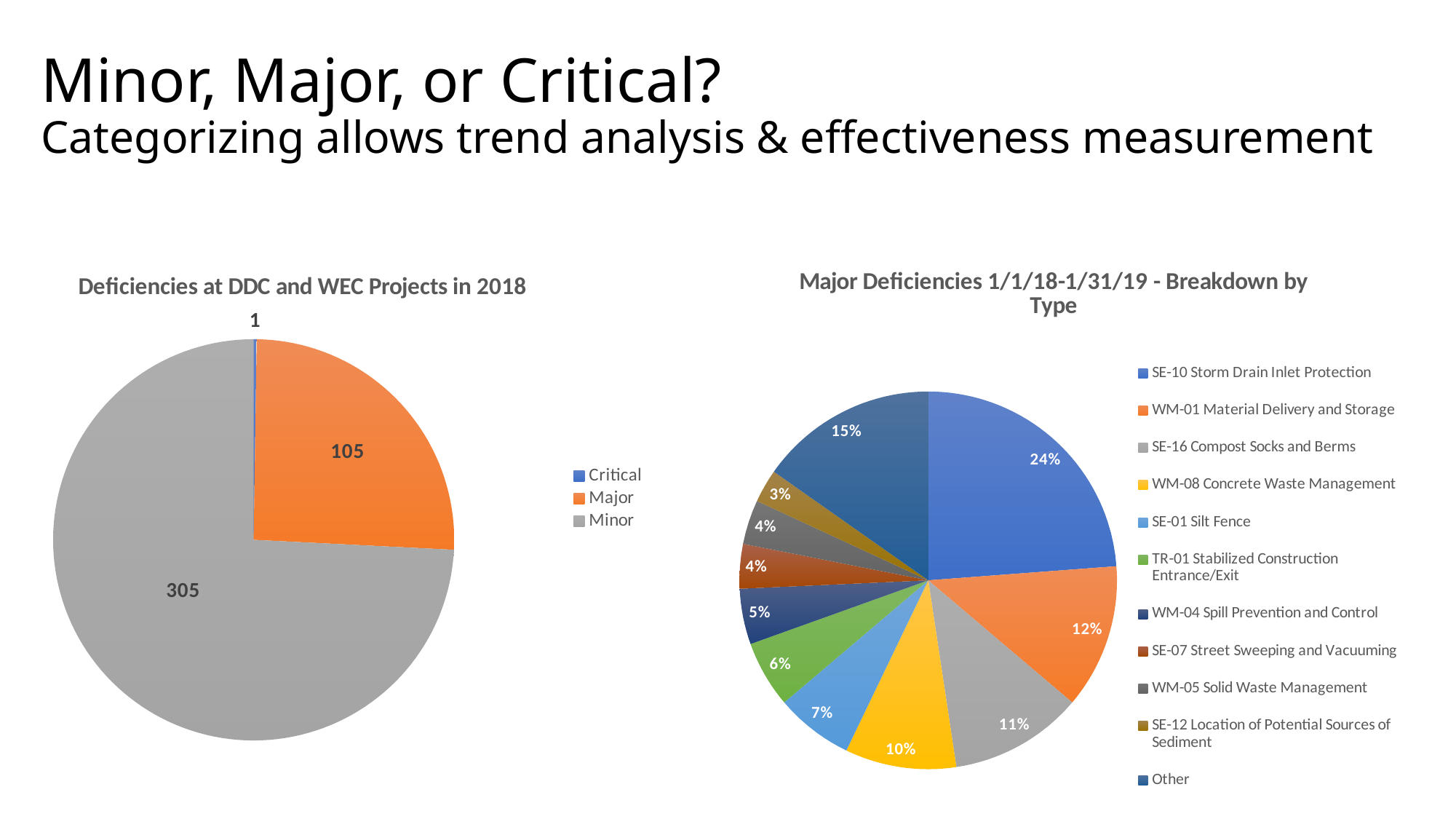
In the chart titled "Deficiencies at DDC and WEC Projects in 2018", what is the value for Major? 105 In the chart titled "Deficiencies at DDC and WEC Projects in 2018", what is the difference between the Minor and Major values? 200 In the chart titled "Major Deficiencies 1/1/18-1/31/19 - Breakdown by Type", what share does WM-08 Concrete Waste Management have? 10% In the chart titled "Deficiencies at DDC and WEC Projects in 2018", how many categories does the legend list? 3 In the chart titled "Major Deficiencies 1/1/18-1/31/19 - Breakdown by Type", which type has the largest share? SE-10 Storm Drain Inlet Protection In the chart titled "Major Deficiencies 1/1/18-1/31/19 - Breakdown by Type", which is larger: the share for WM-01 Material Delivery and Storage or the share for SE-01 Silt Fence? WM-01 Material Delivery and Storage What kind of chart is the one titled "Deficiencies at DDC and WEC Projects in 2018"? Pie chart In the chart titled "Major Deficiencies 1/1/18-1/31/19 - Breakdown by Type", what is the share labelled for the Other slice? 15% In the chart titled "Deficiencies at DDC and WEC Projects in 2018", what is the value for Minor? 305 In the chart titled "Major Deficiencies 1/1/18-1/31/19 - Breakdown by Type", what share does SE-10 Storm Drain Inlet Protection have? 24% In the chart titled "Major Deficiencies 1/1/18-1/31/19 - Breakdown by Type", how many slices does the pie have? 11 In the chart titled "Deficiencies at DDC and WEC Projects in 2018", which category has the lowest value? Critical